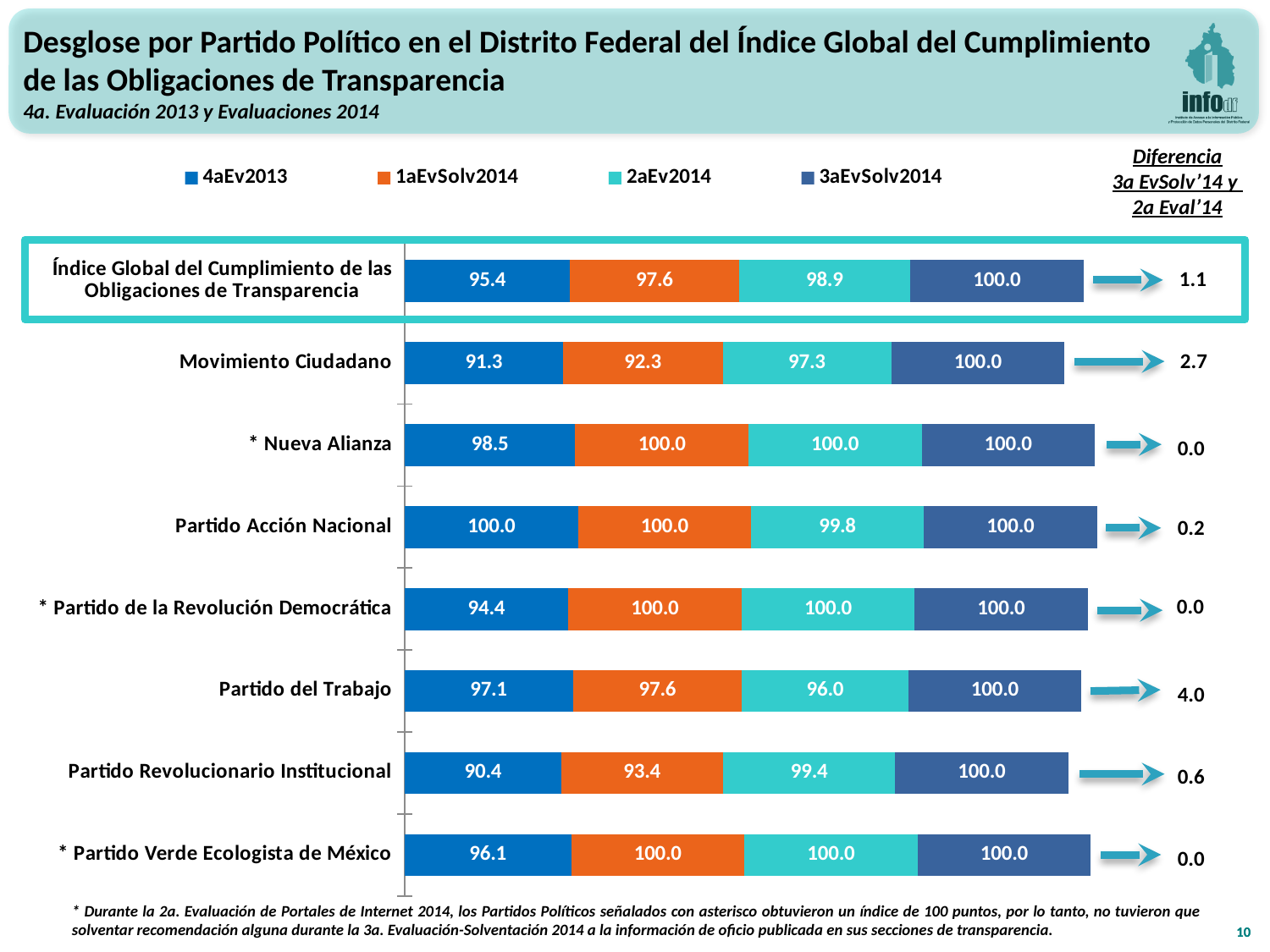
How many series does the legend list? 4 Which category has the lowest 2aEv2014 value? Partido del Trabajo What is the 1aEvSolv2014 value for Partido del Trabajo? 97.6 What kind of chart is shown on the slide? Stacked bar chart Which category has the lowest 4aEv2013 value? Partido Revolucionario Institucional Which has a larger 4aEv2013 value, Nueva Alianza or Partido del Trabajo? Nueva Alianza How many categories are shown on the chart? 8 What is the difference between the 2aEv2014 and 4aEv2013 values for Movimiento Ciudadano? 6.0 What is the 4aEv2013 value for Movimiento Ciudadano? 91.3 Which category has the highest 4aEv2013 value? Partido Acción Nacional What is the 'Diferencia' value shown for Partido del Trabajo? 4.0 What is the 2aEv2014 value for Partido Revolucionario Institucional? 99.4